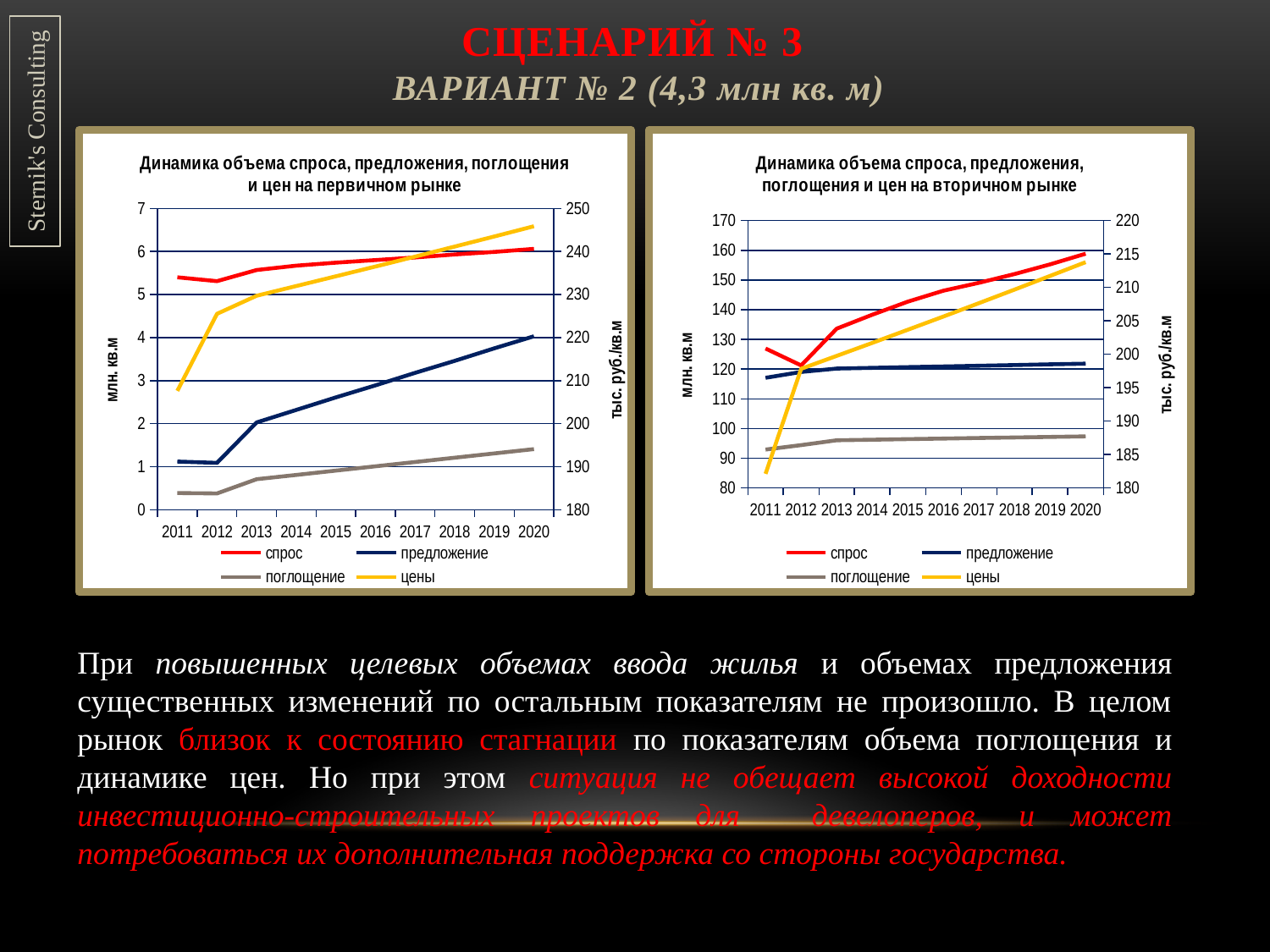
In the right chart (вторичный рынок), is the value of 'поглощение' in 2020 greater or less than 100? less In the left chart (первичный рынок), which is larger in 2020: 'спрос' or 'предложение'? спрос In the right chart (вторичный рынок), is the value of 'спрос' in 2020 greater or less than 150? greater In the left chart (первичный рынок), is the value of 'предложение' in 2020 greater or less than 3? greater In the left chart (первичный рынок), does the 'предложение' series rise or fall from 2011 to 2020? rise How many years are shown on the x axis of the left chart (первичный рынок)? 10 What kind of chart is the left chart, 'Динамика объема спроса, предложения, поглощения и цен на первичном рынке'? line chart What is the label of the right-hand vertical axis of the right chart (вторичный рынок)? тыс. руб./кв.м In the right chart (вторичный рынок), does the 'спрос' series rise or fall from 2012 to 2020? rise How many series does the legend of the right chart, 'Динамика объема спроса, предложения, поглощения и цен на вторичном рынке', list? 4